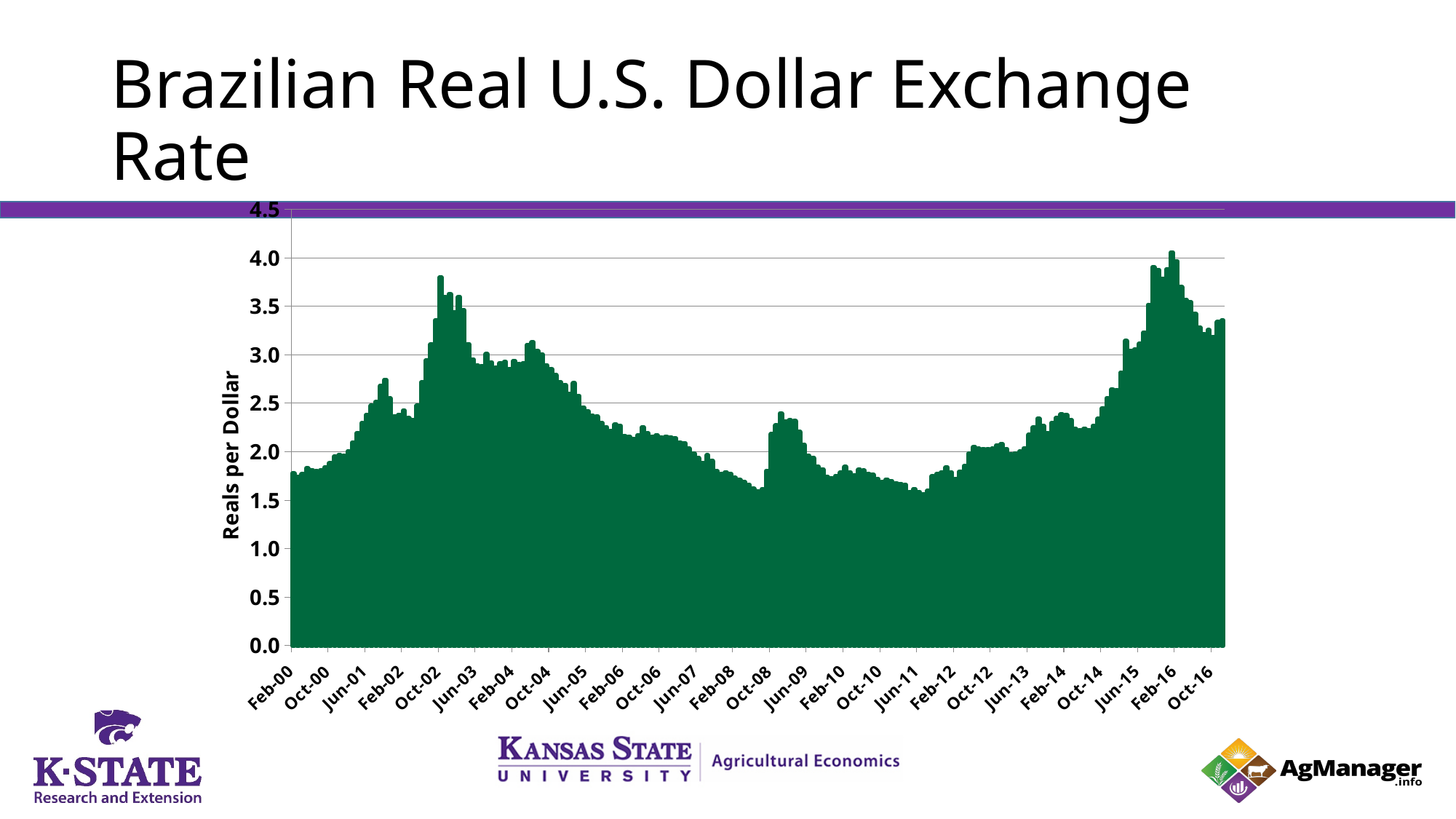
Is the value for Feb-16 greater or less than 3.5? greater Is the value for Jun-11 greater or less than 2.0? less Is the value for Feb-00 greater or less than 2.0? less Does the exchange rate rise or fall between Feb-14 and Feb-16? rise Does the exchange rate rise or fall between Jun-03 and Jun-07? fall Which is larger, the value at Oct-02 or the value at Oct-08? Oct-02 What is the label on the vertical axis of the chart? Reals per Dollar How many date labels are shown along the x axis of the chart? 26 What is the title of the chart on the slide? Brazilian Real U.S. Dollar Exchange Rate